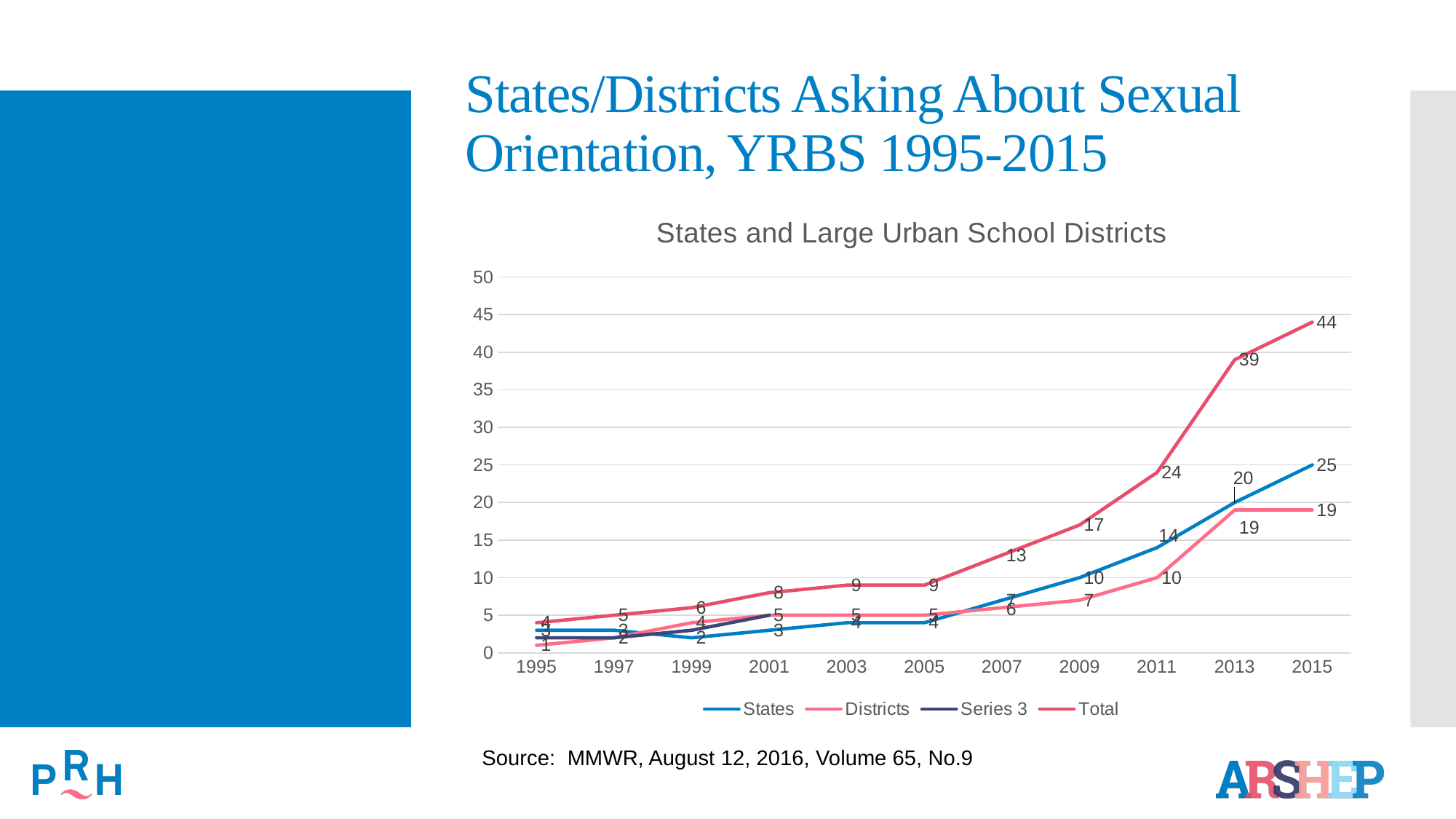
What is the difference between the Total values for 2015 and 2013? 5 Does the Total series rise or fall from 1995 to 2015? rise What kind of chart is shown on the slide? line chart How many years are shown on the x axis? 11 In which year is the Total series highest? 2015 Is the Total value for 2011 greater or less than 20? greater What is the Total value for 2015? 44 How many series does the legend list? 4 What is the title of the chart? States and Large Urban School Districts What is the Districts value for 2011? 10 In 2015, which is larger, the States value or the Districts value? States What is the States value for 2013? 20